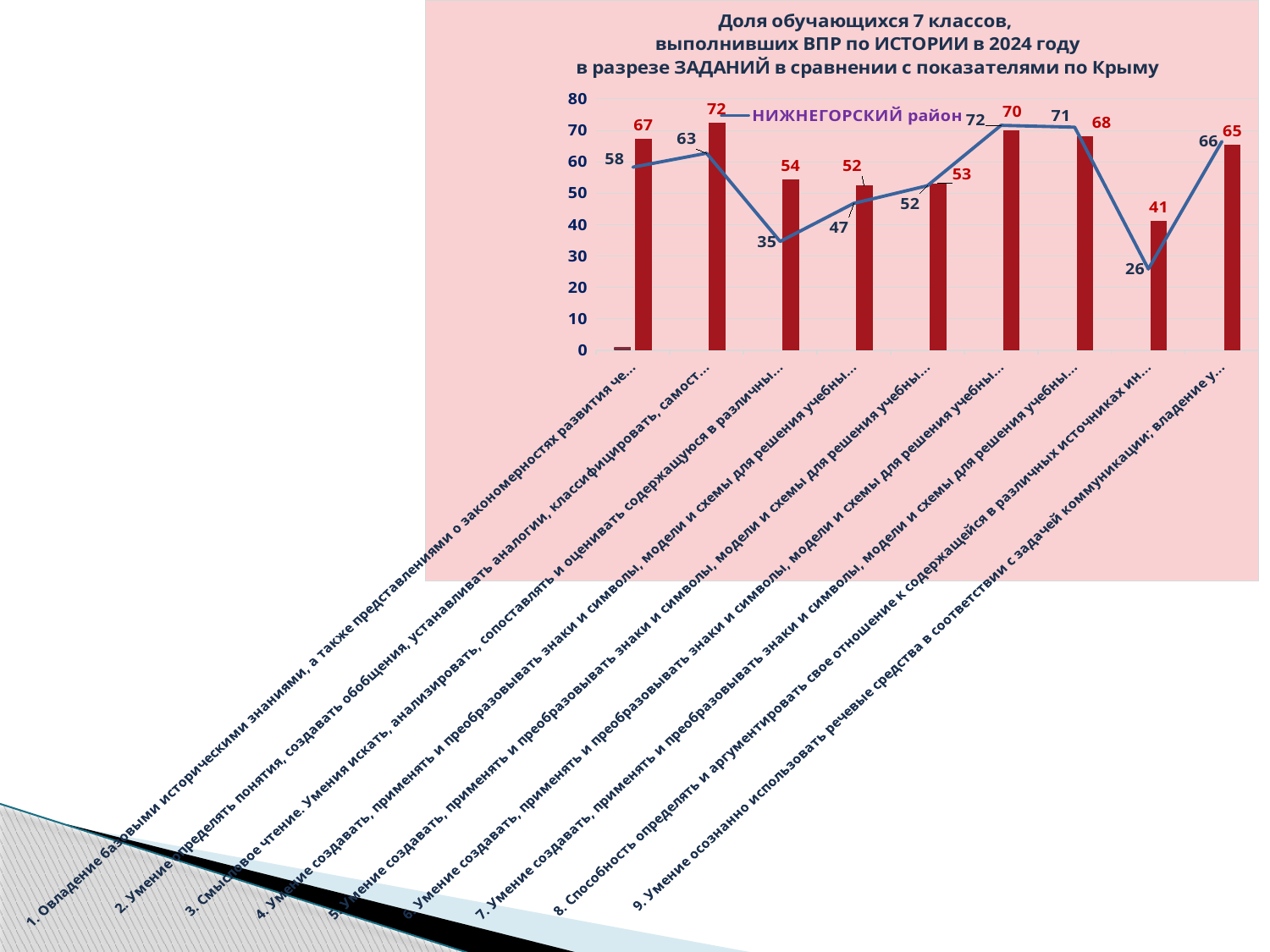
For task 3, what is the difference between the red bar value and the blue line value? 19 What is the value of the red bar for task 2? 72 Is the red bar value for task 8 greater or less than 50? less For which task is the red bar the highest? Task 2 For task 1, which is larger: the red bar value or the blue line (НИЖНЕГОРСКИЙ район) value? The red bar (67) What is the value of the blue line (НИЖНЕГОРСКИЙ район) for task 9? 66 How many tasks (categories) are shown on the x axis? 9 For task 8, what is the difference between the red bar value and the blue line value? 15 What is the value of the blue line (НИЖНЕГОРСКИЙ район) for task 3? 35 What kind of chart is shown on the slide? A bar chart combined with a line For which task is the blue line (НИЖНЕГОРСКИЙ район) at its lowest value? Task 8 What is the value of the red bar for task 8? 41